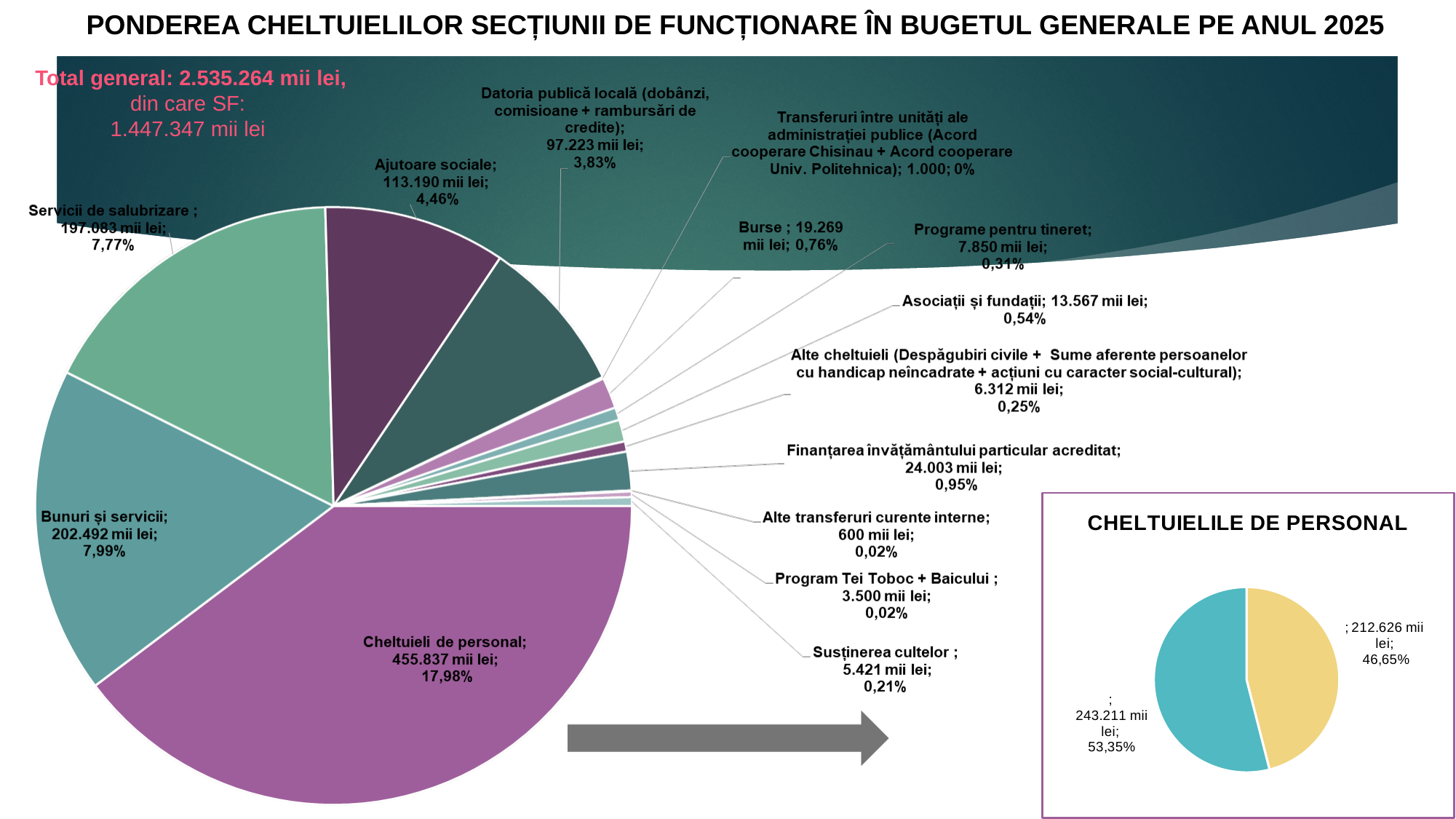
In the main pie chart, what is the value for Ajutoare sociale? 113.190 mii lei What kind of chart is the main chart on the slide? Pie chart How many slices does the CHELTUIELILE DE PERSONAL pie chart have? 2 In the main pie chart, what is the value for Finanțarea învățământului particular acreditat? 24.003 mii lei In the CHELTUIELILE DE PERSONAL chart, what percentage share does the 212.626 mii lei slice have? 46,65% In the main pie chart, what is the difference in mii lei between Cheltuieli de personal and Bunuri și servicii? 253.345 mii lei In the CHELTUIELILE DE PERSONAL chart, what is the value of the larger slice? 243.211 mii lei In the main pie chart, what percentage share does Burse have? 0,76% In the main pie chart, which category has the largest slice? Cheltuieli de personal In the main pie chart, what is the value for Cheltuieli de personal? 455.837 mii lei In the main pie chart, what percentage share does Bunuri și servicii have? 7,99% In the main pie chart, which is larger: Bunuri și servicii or Servicii de salubrizare? Bunuri și servicii